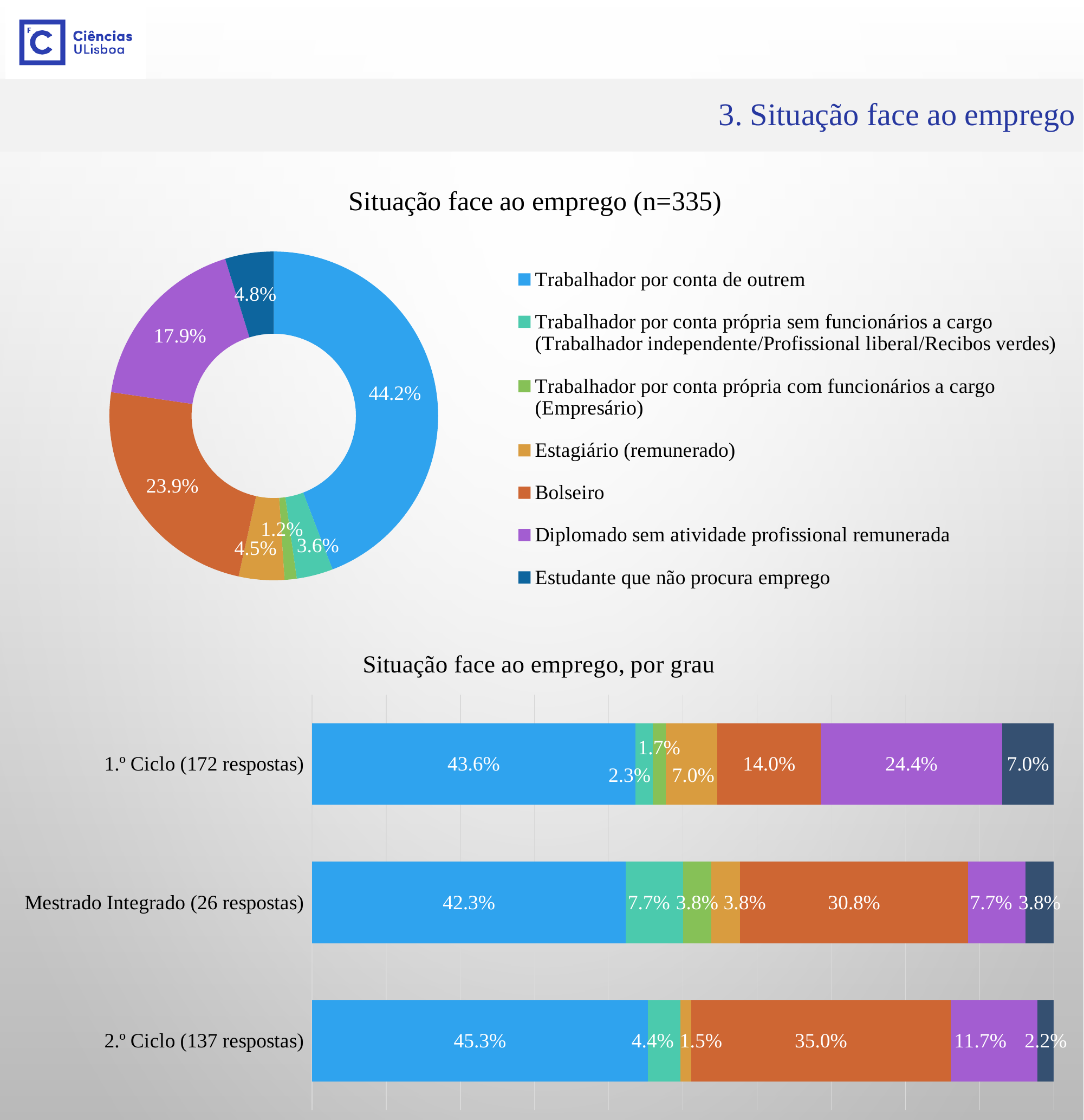
How many categories does the legend of the top chart "Situação face ao emprego (n=335)" list? 7 In the top chart "Situação face ao emprego (n=335)", what share is shown for Diplomado sem atividade profissional remunerada? 17.9% In the top chart "Situação face ao emprego (n=335)", what is the difference in percentage points between Trabalhador por conta de outrem and Bolseiro? 20.3 percentage points In the bottom chart "Situação face ao emprego, por grau", what is the value of the purple segment for 1.º Ciclo (172 respostas)? 24.4% In the bottom chart "Situação face ao emprego, por grau", what is the value of the orange (Bolseiro) segment for 2.º Ciclo (137 respostas)? 35.0% In the top chart "Situação face ao emprego (n=335)", which category has the largest share? Trabalhador por conta de outrem What kind of chart is the bottom chart titled "Situação face ao emprego, por grau"? stacked bar chart In the top chart "Situação face ao emprego (n=335)", what share is shown for Bolseiro? 23.9% In the bottom chart "Situação face ao emprego, por grau", which has the larger orange (Bolseiro) segment: 1.º Ciclo (172 respostas) or 2.º Ciclo (137 respostas)? 2.º Ciclo (137 respostas) What kind of chart is the top chart titled "Situação face ao emprego (n=335)"? pie chart (donut) How many degree categories are shown in the bottom chart "Situação face ao emprego, por grau"? 3 In the top chart "Situação face ao emprego (n=335)", which category has the smallest share? Trabalhador por conta própria com funcionários a cargo (Empresário)